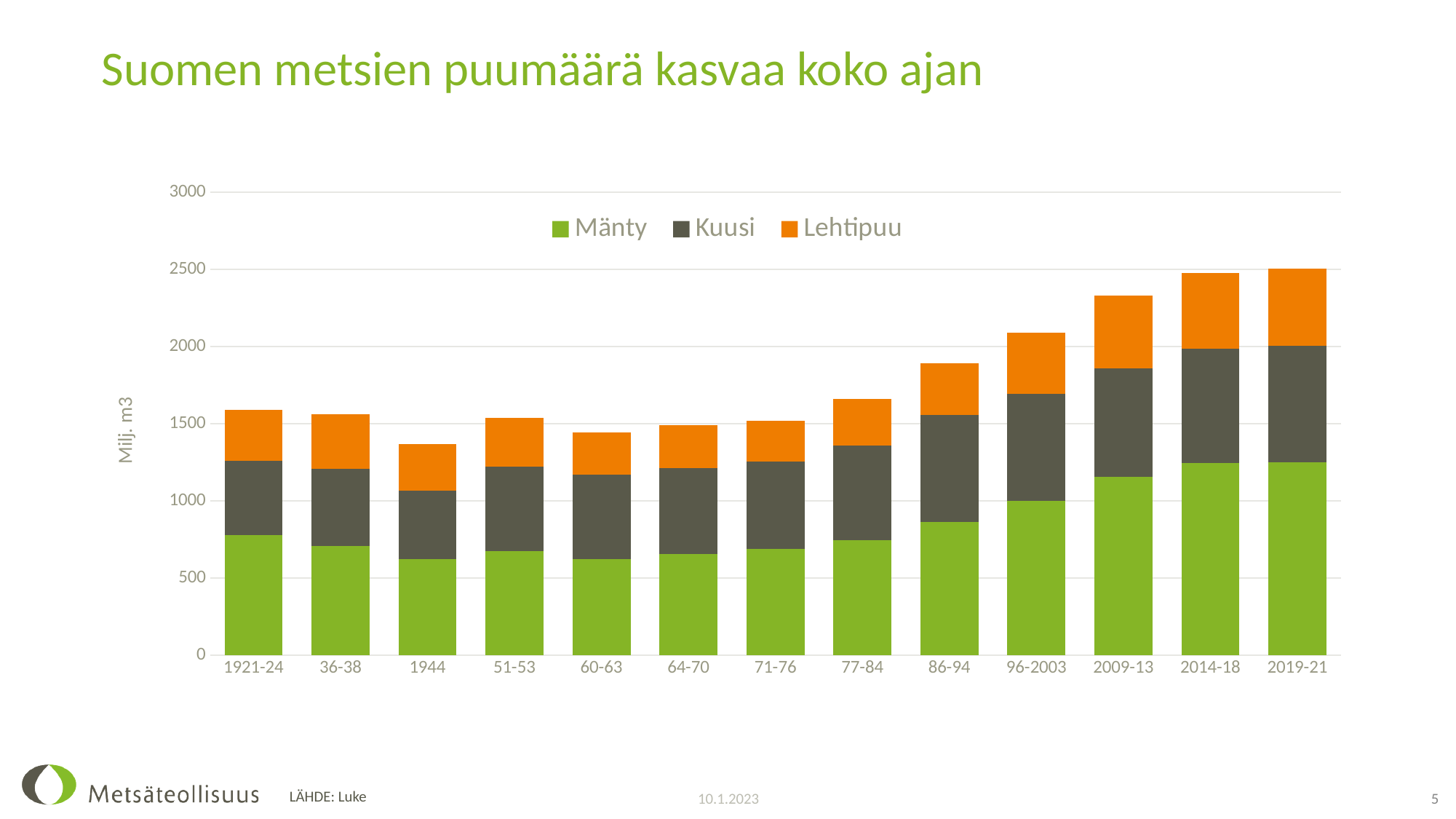
Which period has the lowest total stacked bar? 1944 How many periods (categories) are shown on the x axis? 13 What is the label on the y axis? Milj. m3 Do the total stacked values rise or fall from 86-94 to 2019-21? rise Is the Mänty value for 2019-21 greater or less than 1000? greater Is the total stacked value for 1944 greater or less than 1500? less Is the Mänty value for 1944 greater or less than 1000? less What kind of chart is shown on the slide? stacked bar chart Which has the larger total stacked bar, 1921-24 or 2019-21? 2019-21 How many series does the legend list? 3